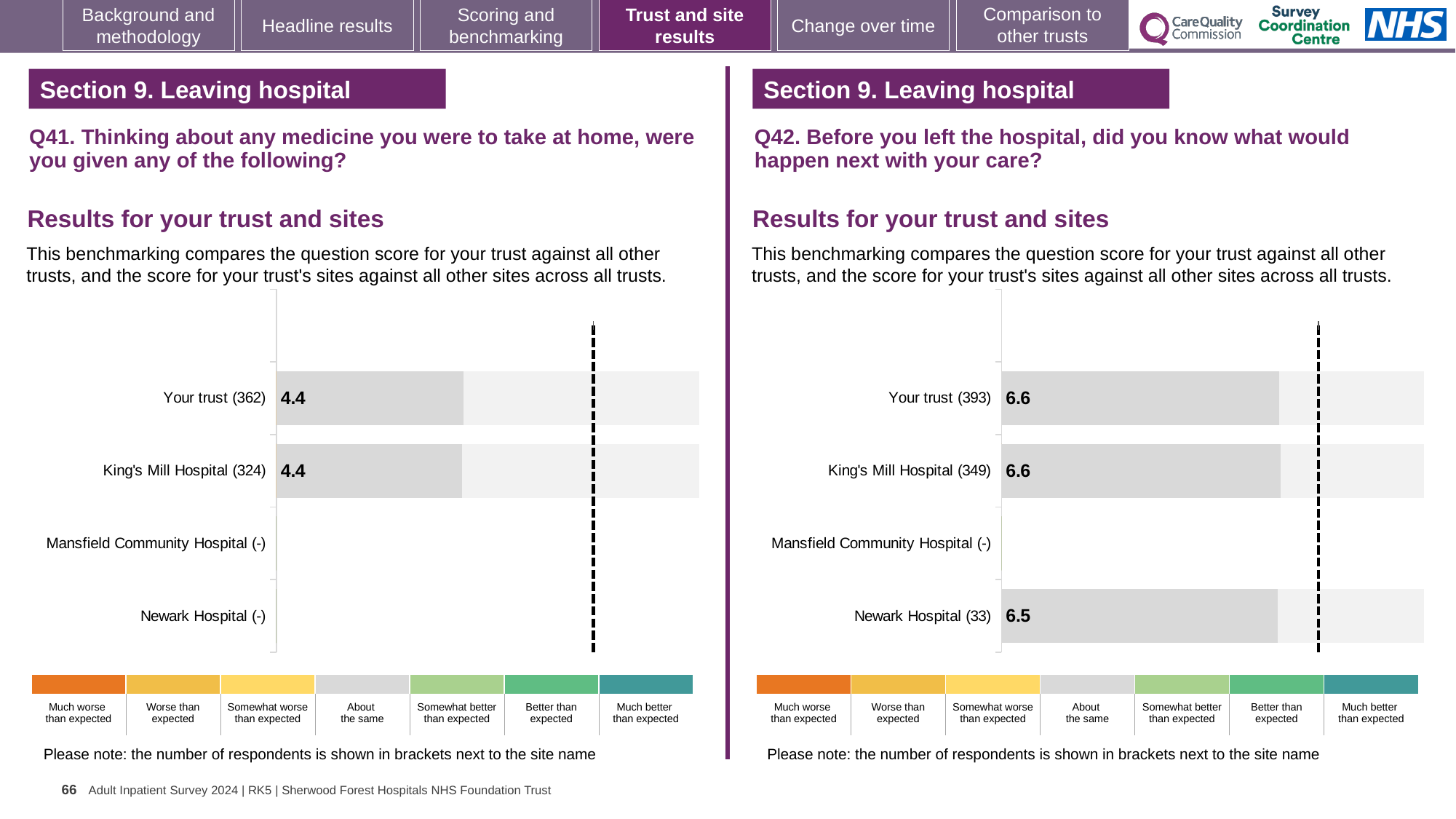
How many categories (rows) are listed on the y axis of the Q41 chart on the left? 4 In the Q42 chart on the right, how many respondents are shown in brackets for Newark Hospital? 33 In the Q42 chart on the right, what is the score for Newark Hospital? 6.5 In the Q41 chart on the left, how many respondents are shown in brackets for Your trust? 362 In the Q41 chart on the left, what is the score for Your trust? 4.4 In the Q42 chart on the right, what is the score for Your trust? 6.6 What kind of chart is used for the Q42 results on the right? Bar chart In the Q42 chart on the right, which has the higher score, Your trust or Newark Hospital? Your trust In the Q42 chart on the right, which site with a printed score has the lowest score? Newark Hospital In the Q41 chart on the left, what is the score for King's Mill Hospital? 4.4 In the Q41 chart on the left, which two sites have no score shown (marked with a dash)? Mansfield Community Hospital and Newark Hospital In the Q42 chart on the right, what is the difference between the scores for King's Mill Hospital and Newark Hospital? 0.1